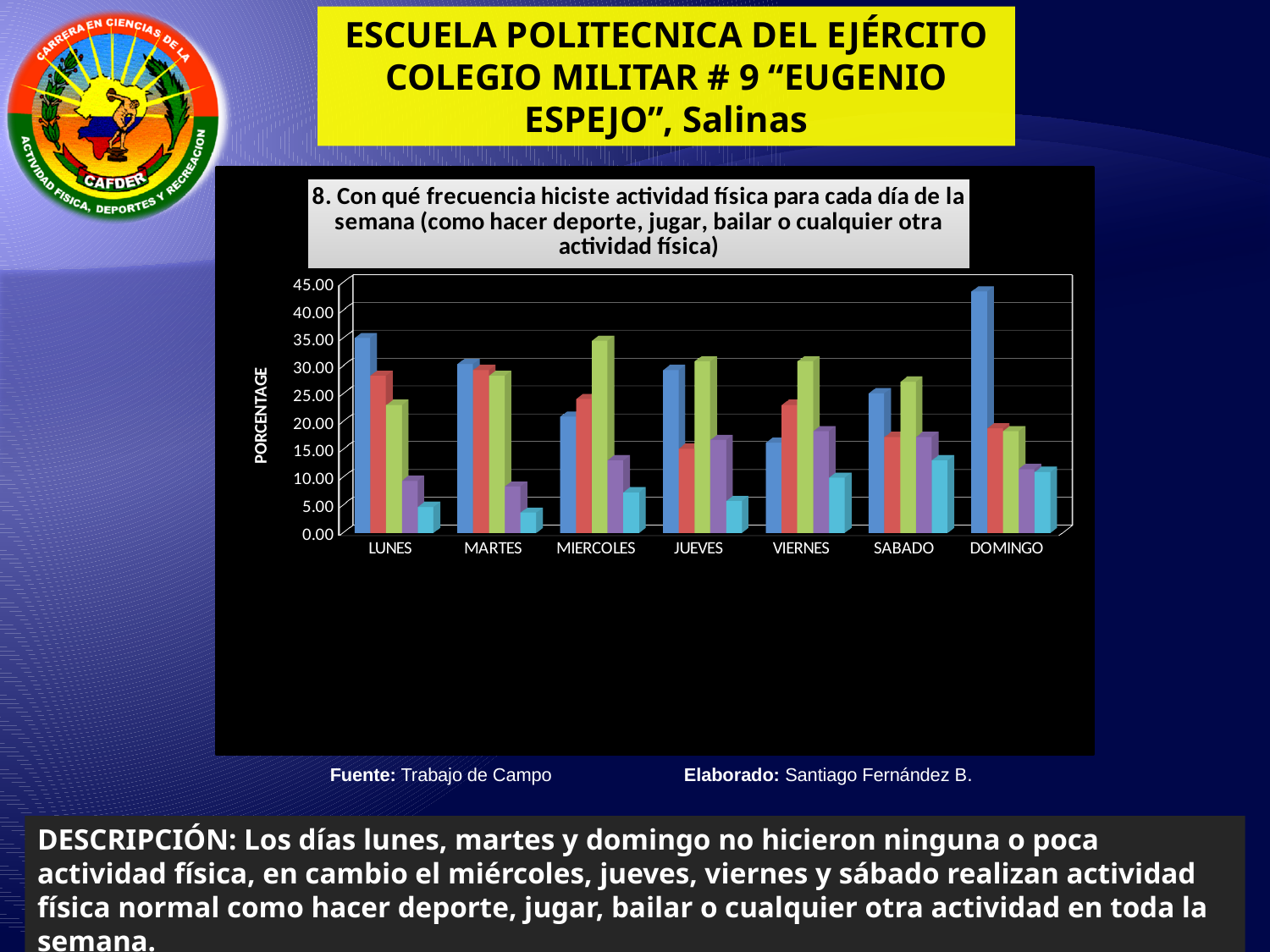
Which day has the tallest blue bar in the chart? DOMINGO How many bars are plotted for each day in the chart? 5 How many days of the week are shown on the x axis of the chart? 7 Is the value of the purple bar for VIERNES greater or less than 15.00? greater Is the value of the light blue (cyan) bar for MARTES greater or less than 5.00? less What type of chart is shown on the slide? bar chart What is the label on the vertical axis of the chart? PORCENTAGE Is the value of the green bar for MIERCOLES greater or less than 30.00? greater Which is larger, the blue bar for LUNES or the blue bar for MARTES? LUNES For MIERCOLES, which is larger, the green bar or the blue bar? green bar Which day has the tallest bar overall in the chart? DOMINGO